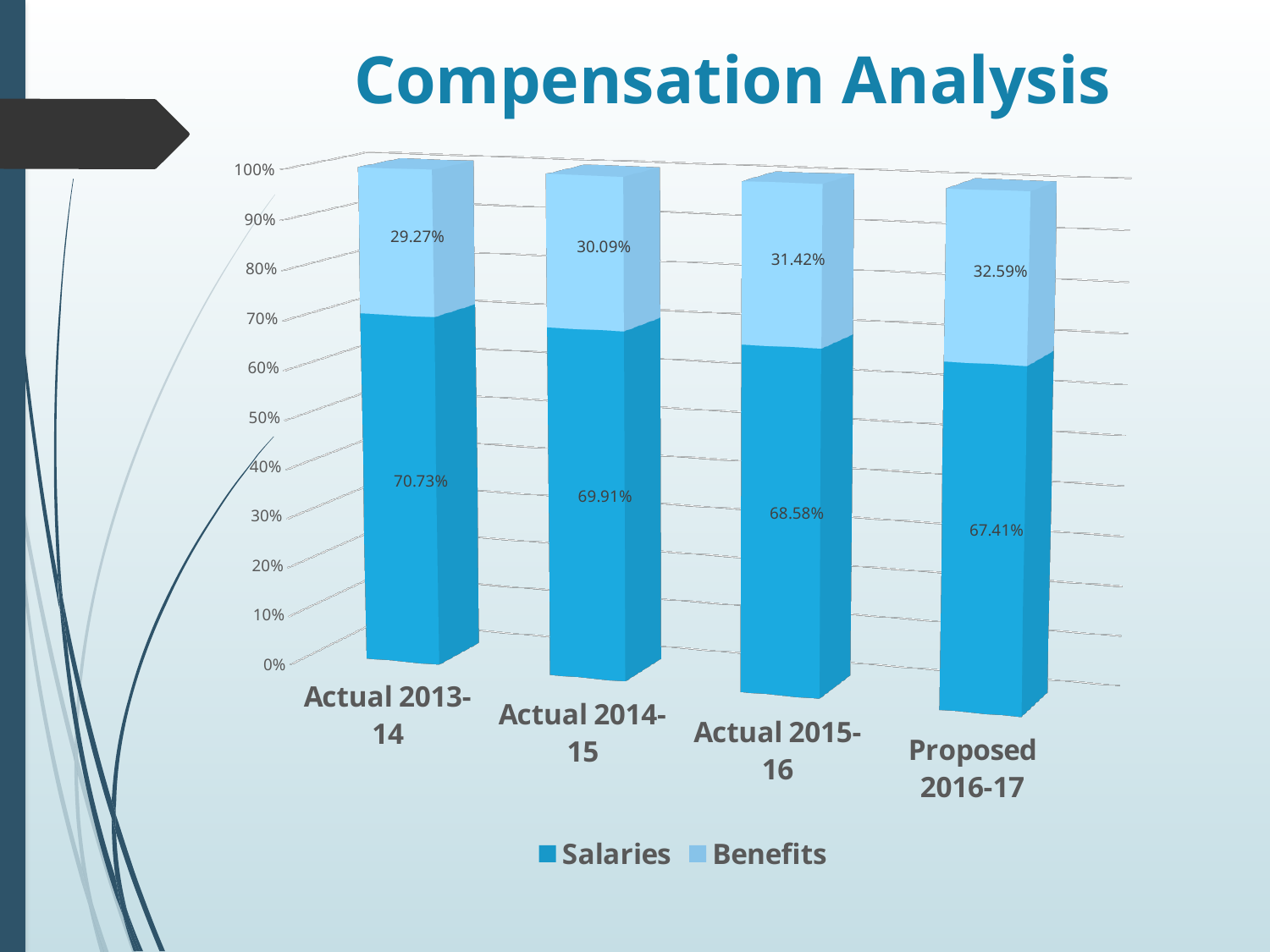
Which is larger: the Benefits value for Actual 2015-16 or for Actual 2014-15? Actual 2015-16 Which category has the lowest Salaries value? Proposed 2016-17 What kind of chart is shown on the slide? Stacked bar chart What is the Salaries value for Actual 2015-16? 68.58% Which category has the highest Benefits value? Proposed 2016-17 What is the Benefits value for Actual 2014-15? 30.09% How many categories are shown on the x axis? 4 How many series does the legend list? 2 What is the difference between the Salaries values for Actual 2013-14 and Proposed 2016-17? 3.32% What is the Benefits value for Proposed 2016-17? 32.59% What is the Salaries value for Actual 2013-14? 70.73% Do the Salaries values rise or fall from Actual 2013-14 to Proposed 2016-17? Fall